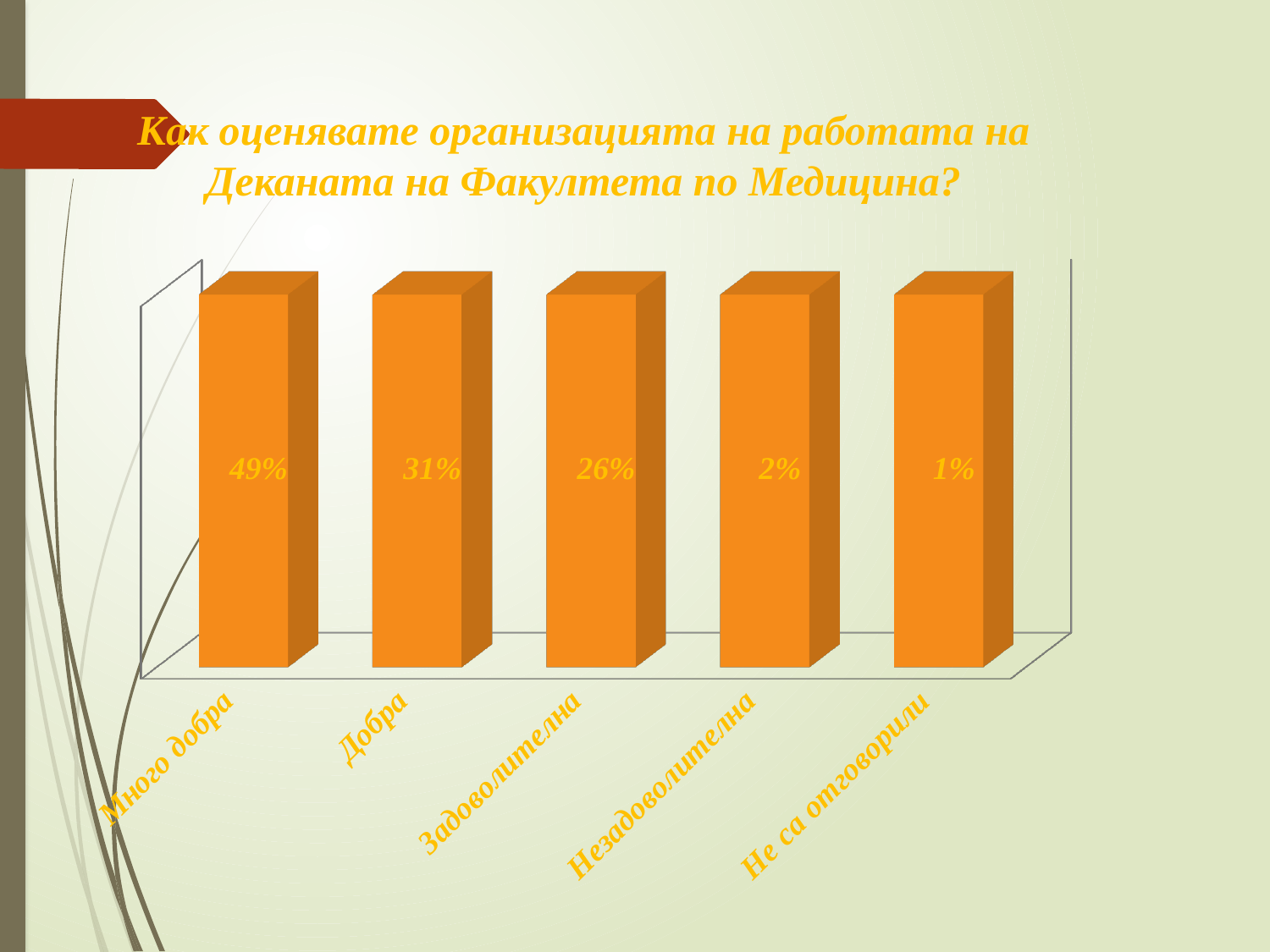
What percentage is labelled for "Не са отговорили"? 1% Which has a larger value, "Задоволителна" or "Незадоволителна"? Задоволителна Which category has the lowest value? Не са отговорили What value is shown for the "Незадоволителна" category? 2% What value is shown for the "Задоволителна" category? 26% What percentage of respondents rated the organisation of the Dean's office work as "Много добра"? 49% Which category has the highest value? Много добра What value is shown for the "Добра" category? 31% What is the difference between the values for "Много добра" and "Добра"? 18% What type of chart is shown on the slide? Bar chart How many categories are shown on the chart? 5 What is the difference between the values for "Добра" and "Задоволителна"? 5%